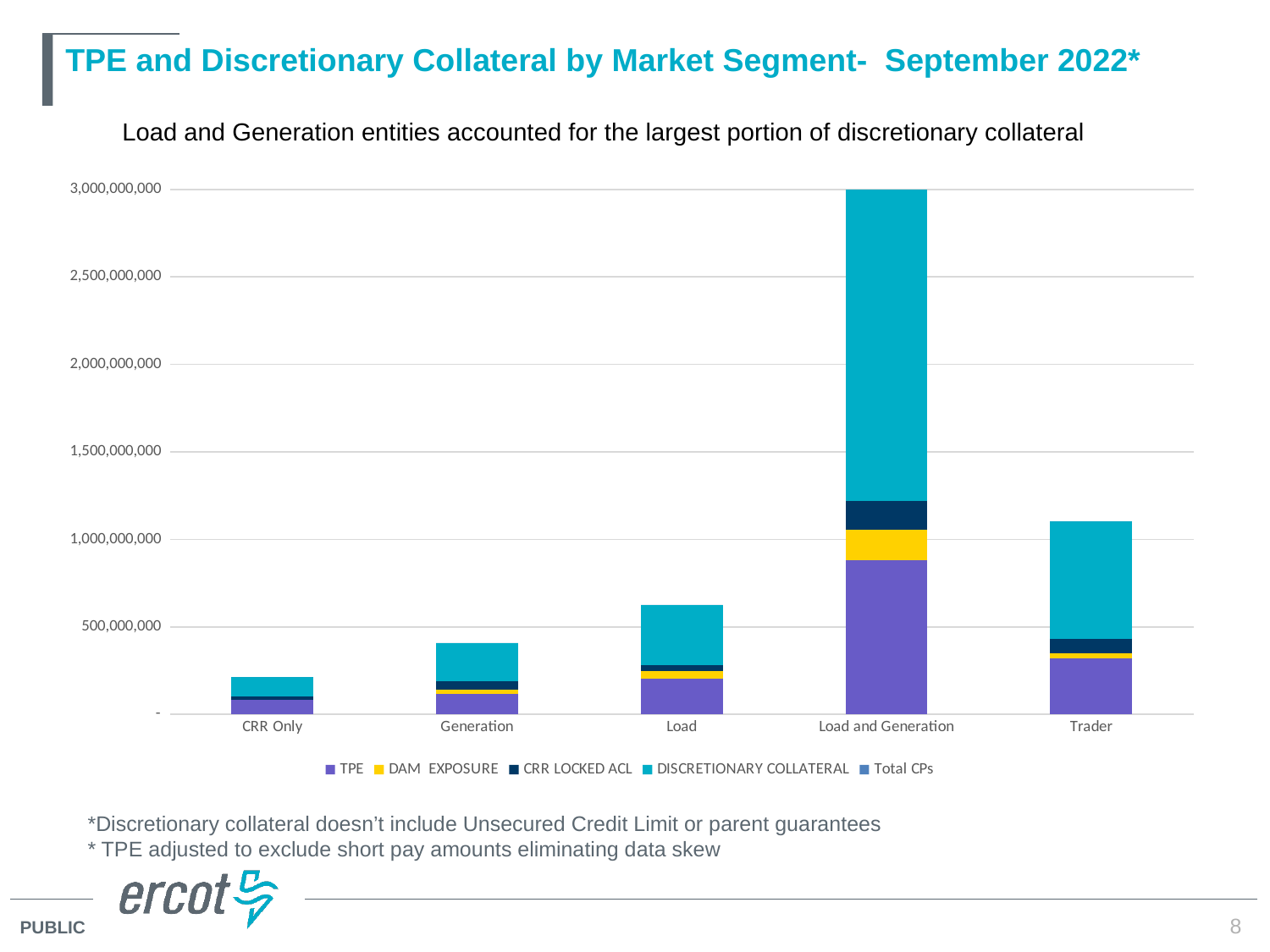
Is the total stacked bar for Load and Generation greater or less than 2,500,000,000? greater How many market segment categories are shown on the x axis? 5 How many series does the legend list? 5 Is the total stacked bar for Trader greater or less than 1,000,000,000? greater Which has the larger total stacked bar, Trader or Load? Trader Which series is shown in the light blue (teal) colour that makes up the top segment of each bar? DISCRETIONARY COLLATERAL Which market segment has the shortest stacked bar? CRR Only Which market segment has the tallest stacked bar? Load and Generation Is the total stacked bar for Generation greater or less than 500,000,000? less What is the title of the slide containing the chart? TPE and Discretionary Collateral by Market Segment- September 2022* What type of chart is shown on the slide? Stacked bar chart